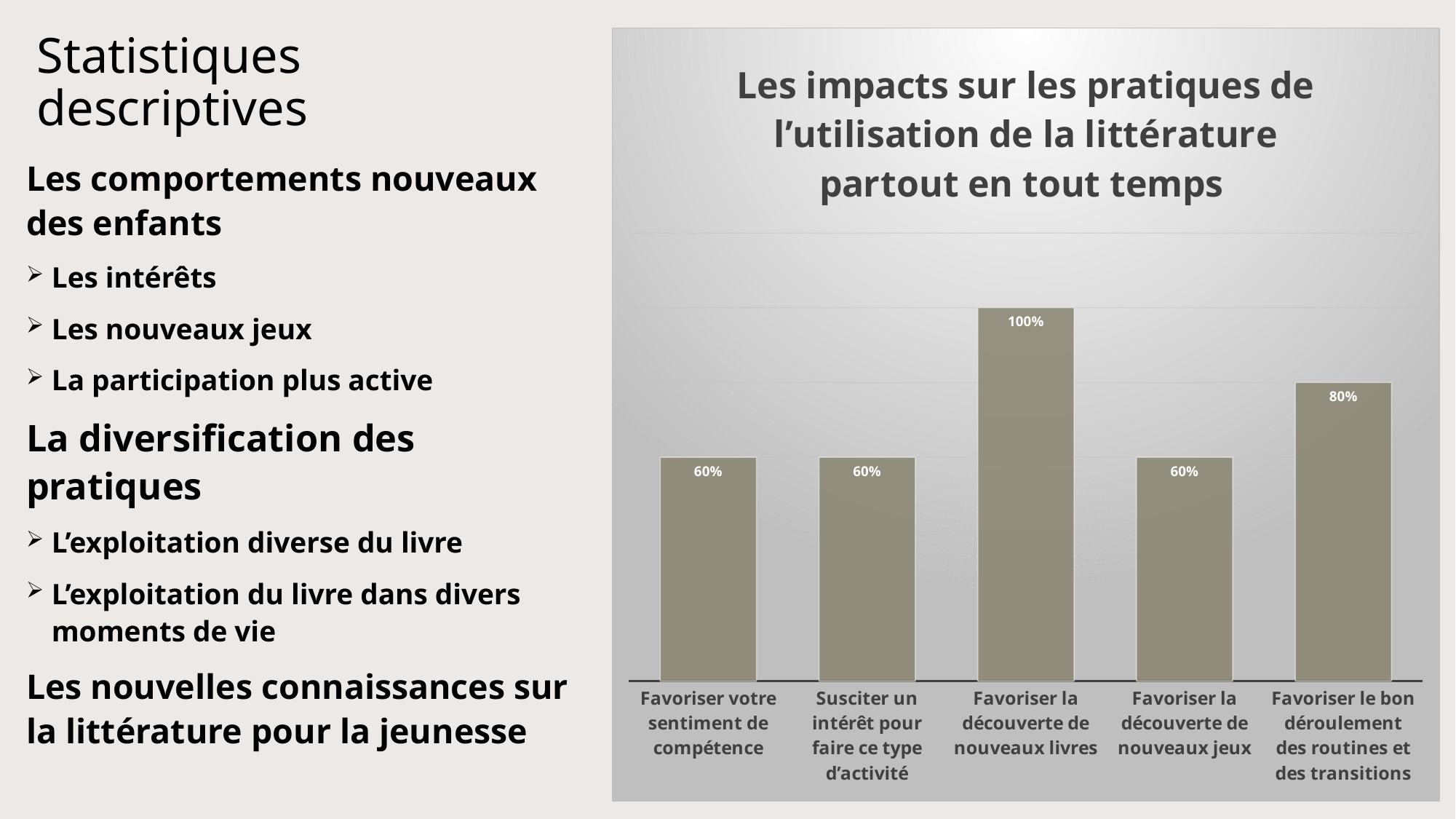
How many categories have a value of 60%? 3 What is the value for 'Favoriser votre sentiment de compétence'? 60% Which is larger, the value for 'Favoriser la découverte de nouveaux jeux' or the value for 'Favoriser le bon déroulement des routines et des transitions'? Favoriser le bon déroulement des routines et des transitions What is the title of the chart? Les impacts sur les pratiques de l'utilisation de la littérature partout en tout temps What is the value for 'Susciter un intérêt pour faire ce type d'activité'? 60% What is the difference between the values for 'Favoriser le bon déroulement des routines et des transitions' and 'Favoriser la découverte de nouveaux jeux'? 20% How many categories are shown in the chart? 5 What is the value for 'Favoriser la découverte de nouveaux livres'? 100% Which category has the highest value? Favoriser la découverte de nouveaux livres What kind of chart is shown on the slide? Bar chart What is the difference between the values for 'Favoriser la découverte de nouveaux livres' and 'Favoriser le bon déroulement des routines et des transitions'? 20% What is the value for 'Favoriser le bon déroulement des routines et des transitions'? 80%